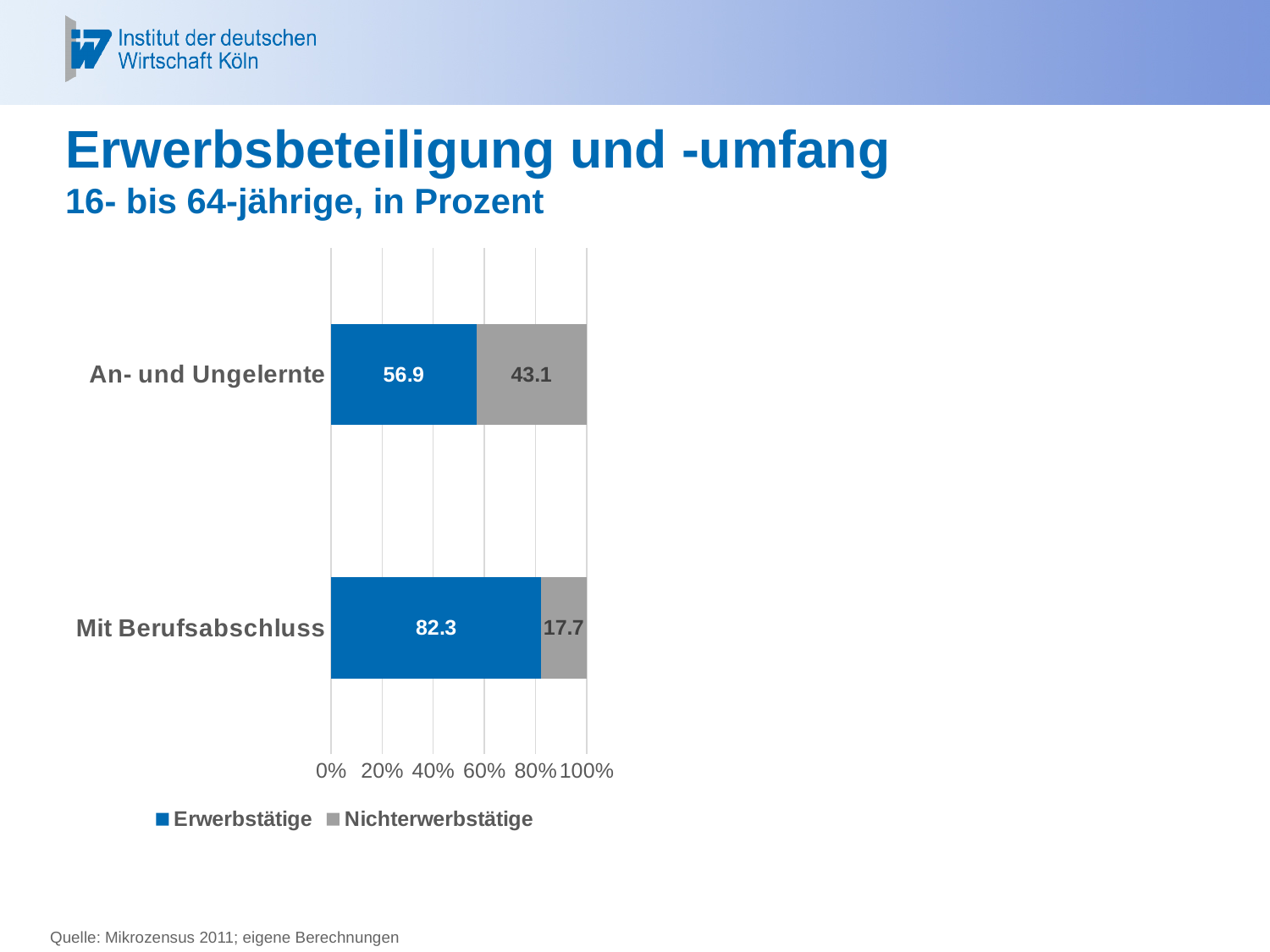
Is the Nichterwerbstätige value larger for An- und Ungelernte or for Mit Berufsabschluss? An- und Ungelernte Which category has the higher Erwerbstätige value? Mit Berufsabschluss What is the Nichterwerbstätige value for An- und Ungelernte? 43.1 Which category has the lower Nichterwerbstätige value? Mit Berufsabschluss What is the difference between the Erwerbstätige values for Mit Berufsabschluss and An- und Ungelernte? 25.4 What kind of chart is shown on the slide? Stacked bar chart What is the Erwerbstätige value for An- und Ungelernte? 56.9 What is the Nichterwerbstätige value for Mit Berufsabschluss? 17.7 Is the Erwerbstätige value for Mit Berufsabschluss greater or less than 80%? greater What is the total of the stacked bar for An- und Ungelernte? 100 How many categories are shown on the chart? 2 How many series does the legend list? 2